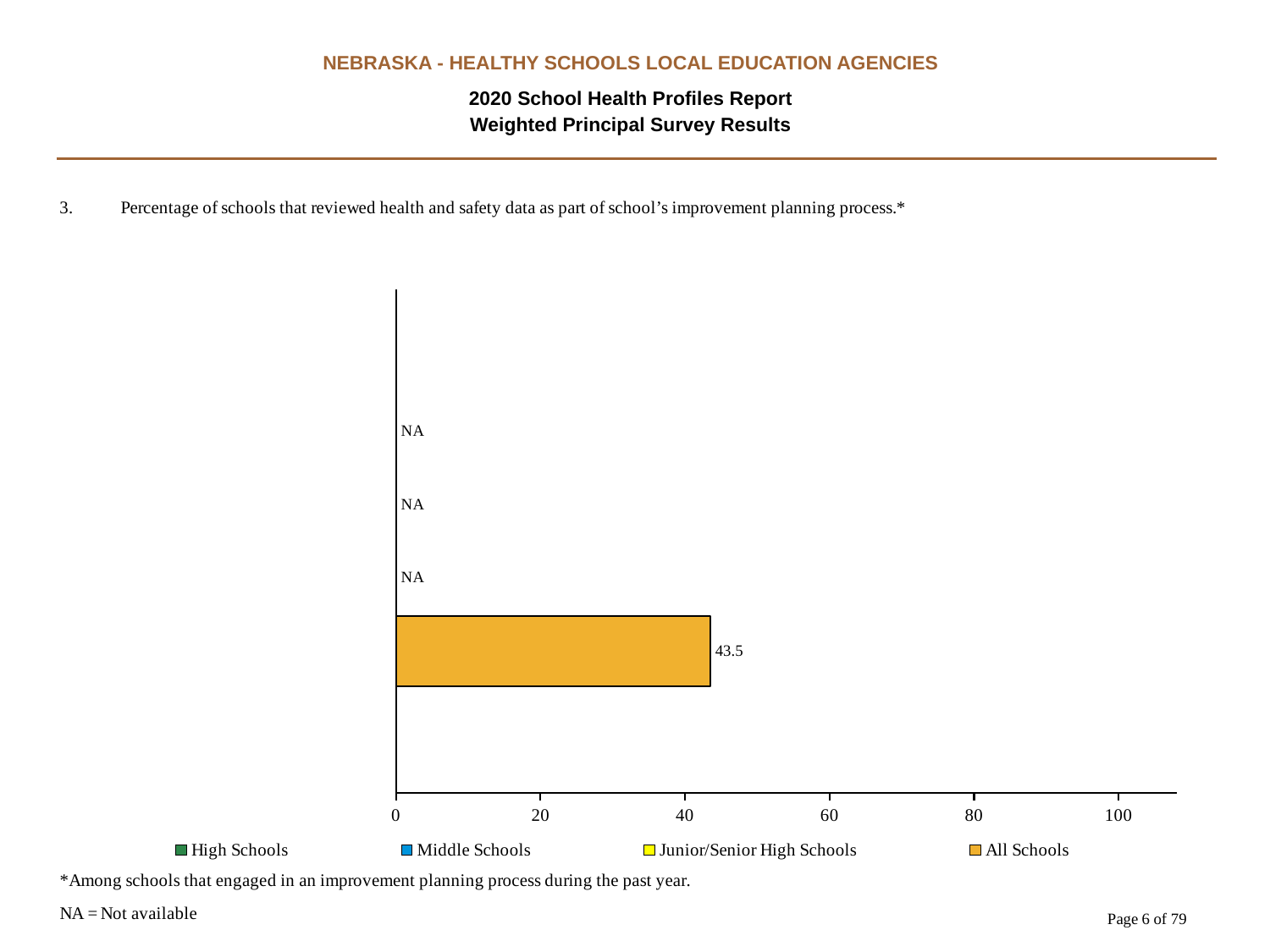
What is the highest value shown on the x axis? 100 Is the value for All Schools greater or less than 60? less How many series does the legend list? 4 What is shown for Middle Schools? NA How many series have a plotted bar with a numeric value? 1 What does NA stand for according to the slide? Not available Is the value for All Schools greater or less than 40? greater What kind of chart is shown? Bar chart What is the value for All Schools? 43.5 What is shown for Junior/Senior High Schools? NA What is shown for High Schools? NA